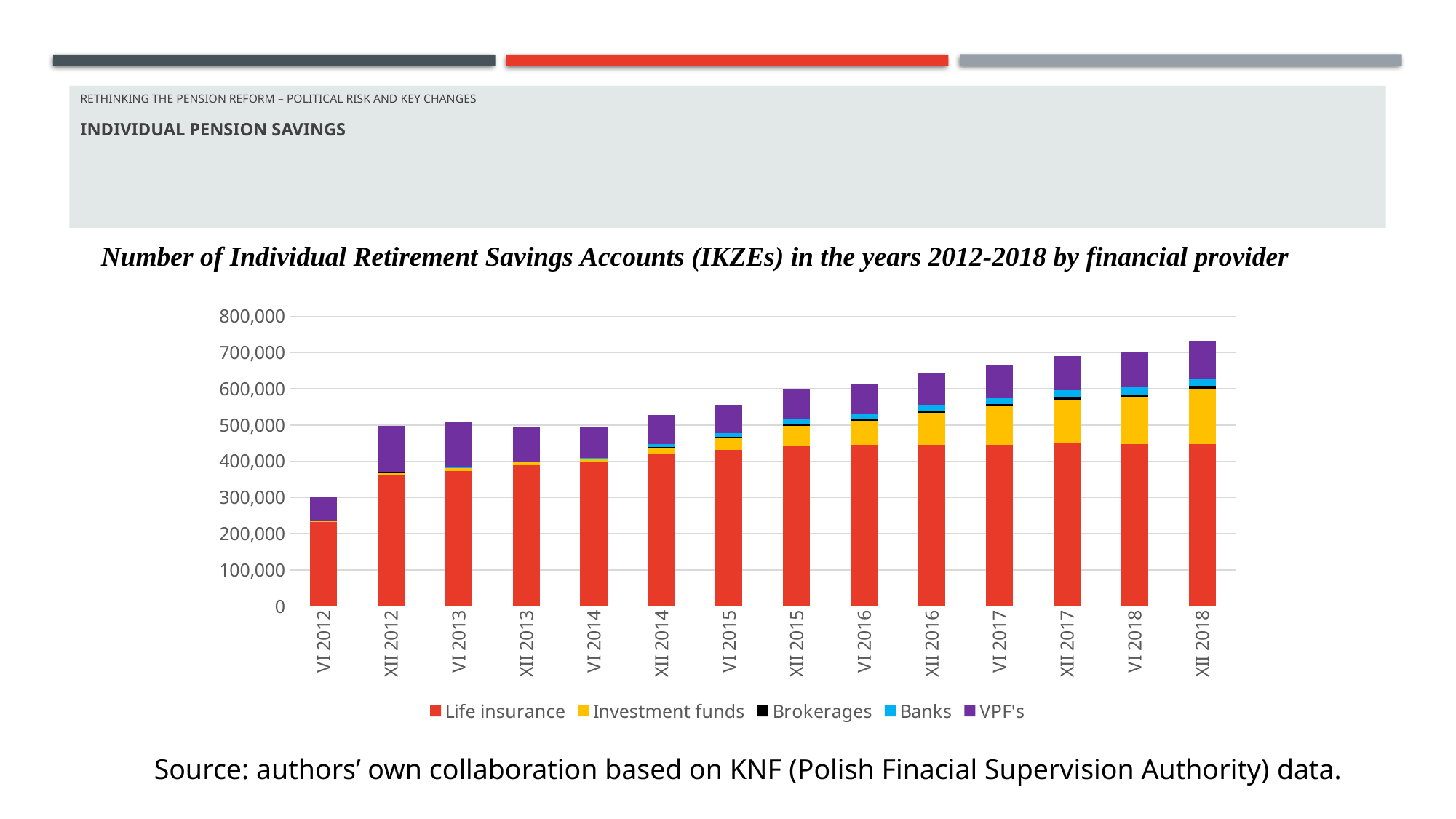
Is the total value for VI 2015 greater or less than 500,000? greater Which period has the highest total number of IKZE accounts? XII 2018 How many series does the legend list? 5 Which period has the lowest total number of IKZE accounts? VI 2012 Is the Life insurance value for XII 2018 greater or less than 400,000? greater Which has the larger total number of accounts, XII 2013 or XII 2014? XII 2014 Is the total value for VI 2012 greater or less than 400,000? less How many time periods (bars) are shown on the x axis? 14 Which series is shown in red in the chart? Life insurance Do the total numbers of IKZE accounts generally rise or fall from VI 2012 to XII 2018? rise What kind of chart is shown on the slide? Stacked bar chart